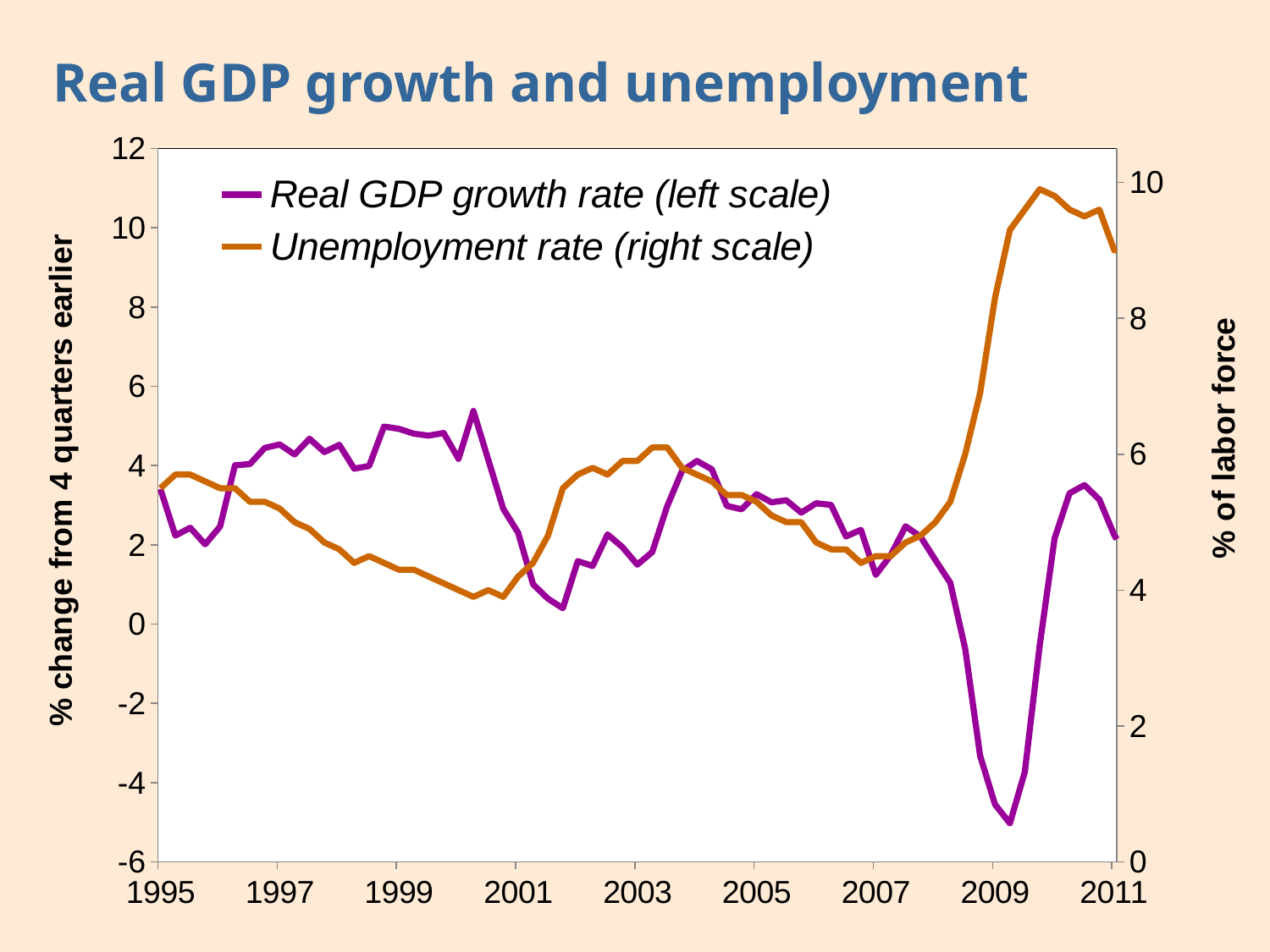
Is the unemployment rate in 2001 greater or less than 6? less Is the unemployment rate in 2007 greater or less than 6? less What are the two series named in the legend? Real GDP growth rate (left scale) and Unemployment rate (right scale) How many series does the legend list? 2 Is the Real GDP growth rate higher in 1999 or in 2009? 1999 What kind of chart is shown on the slide? line chart Does the unemployment rate rise or fall between 2008 and 2009? rise What is the label on the left vertical axis? % change from 4 quarters earlier Is the Real GDP growth rate in 2009 greater or less than 0? less In which year does the Real GDP growth rate reach its lowest value? 2009